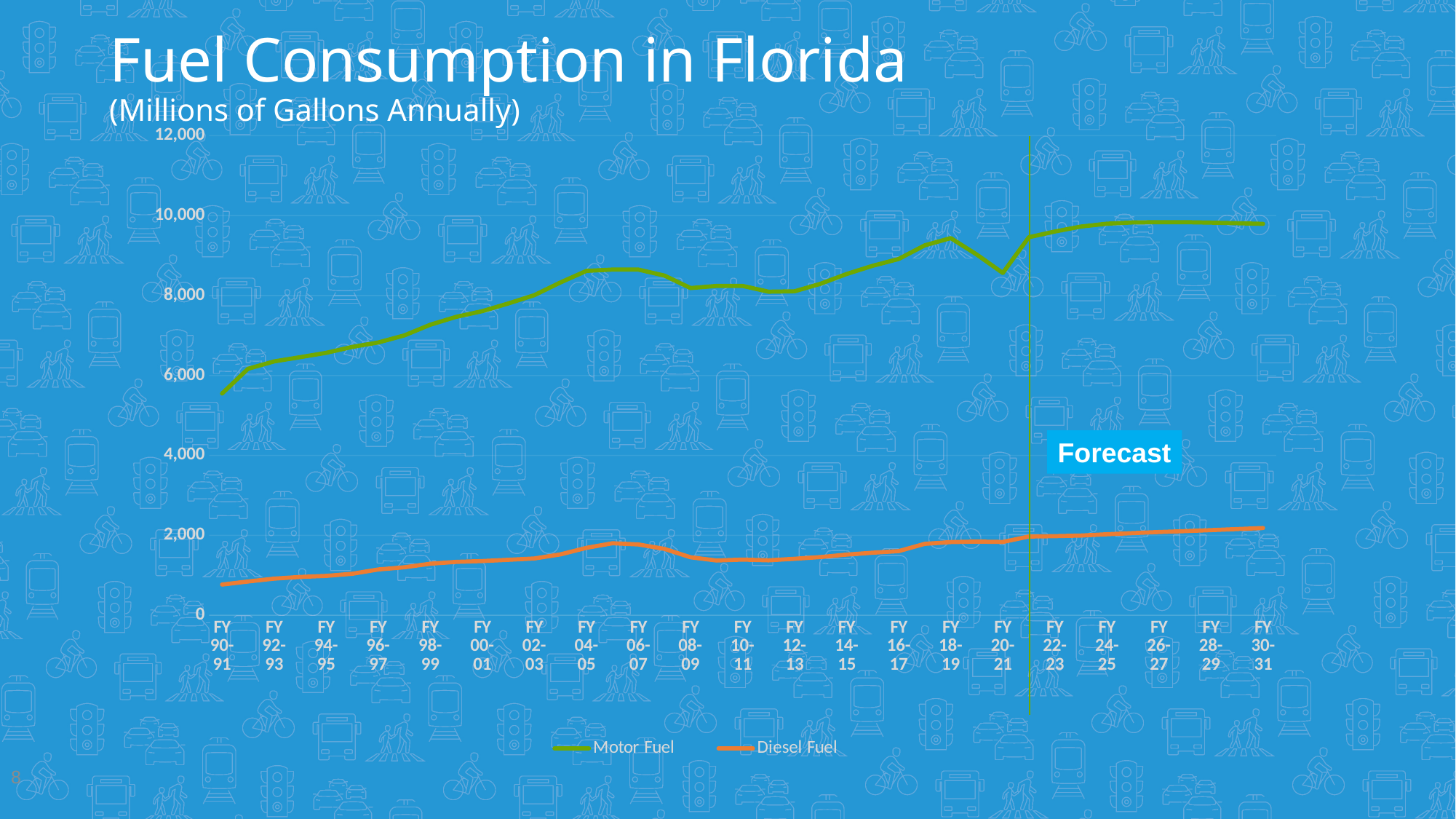
Is the Diesel Fuel value for FY 30-31 greater or less than 2,000? greater Is the Diesel Fuel value for FY 90-91 greater or less than 2,000? less What label marks the portion of the chart to the right of the vertical line? Forecast Is the Motor Fuel value for FY 90-91 greater or less than 6,000? less How many fiscal-year labels are shown along the x axis? 21 What unit does the subtitle say the values are in? Millions of Gallons Annually What kind of chart is shown on the slide? line chart Does the Motor Fuel line rise or fall overall from FY 90-91 to FY 30-31? rise Which series has the larger value in FY 10-11, Motor Fuel or Diesel Fuel? Motor Fuel How many series does the legend list? 2